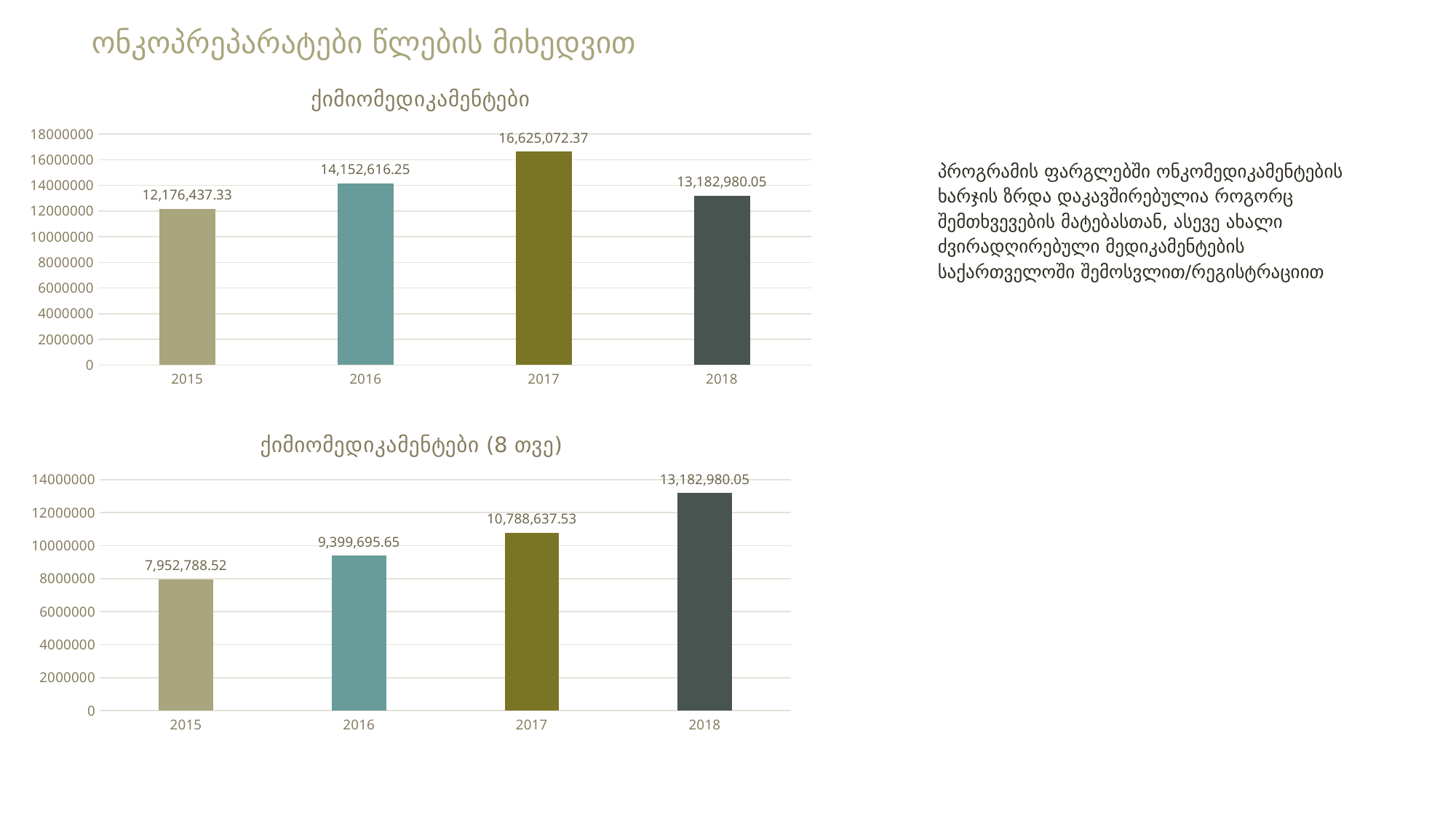
In the top chart, what is the difference between the values for 2017 and 2016? 2,472,456.12 In the top chart, which year has the highest value? 2017 In the top chart, is the value for 2016 greater or less than 14000000? greater How many bars does the bottom chart have? 4 In the top chart, what is the value for 2015? 12,176,437.33 In the bottom chart, what is the difference between the values for 2018 and 2017? 2,394,342.52 In the top chart, which year has the lowest value? 2015 In the bottom chart, do the values rise or fall from 2015 to 2018? rise In the bottom chart, what is the value for 2018? 13,182,980.05 In the bottom chart, which year has the lowest value? 2015 In the bottom chart, what is the value for 2016? 9,399,695.65 In the top chart, what is the value for 2017? 16,625,072.37